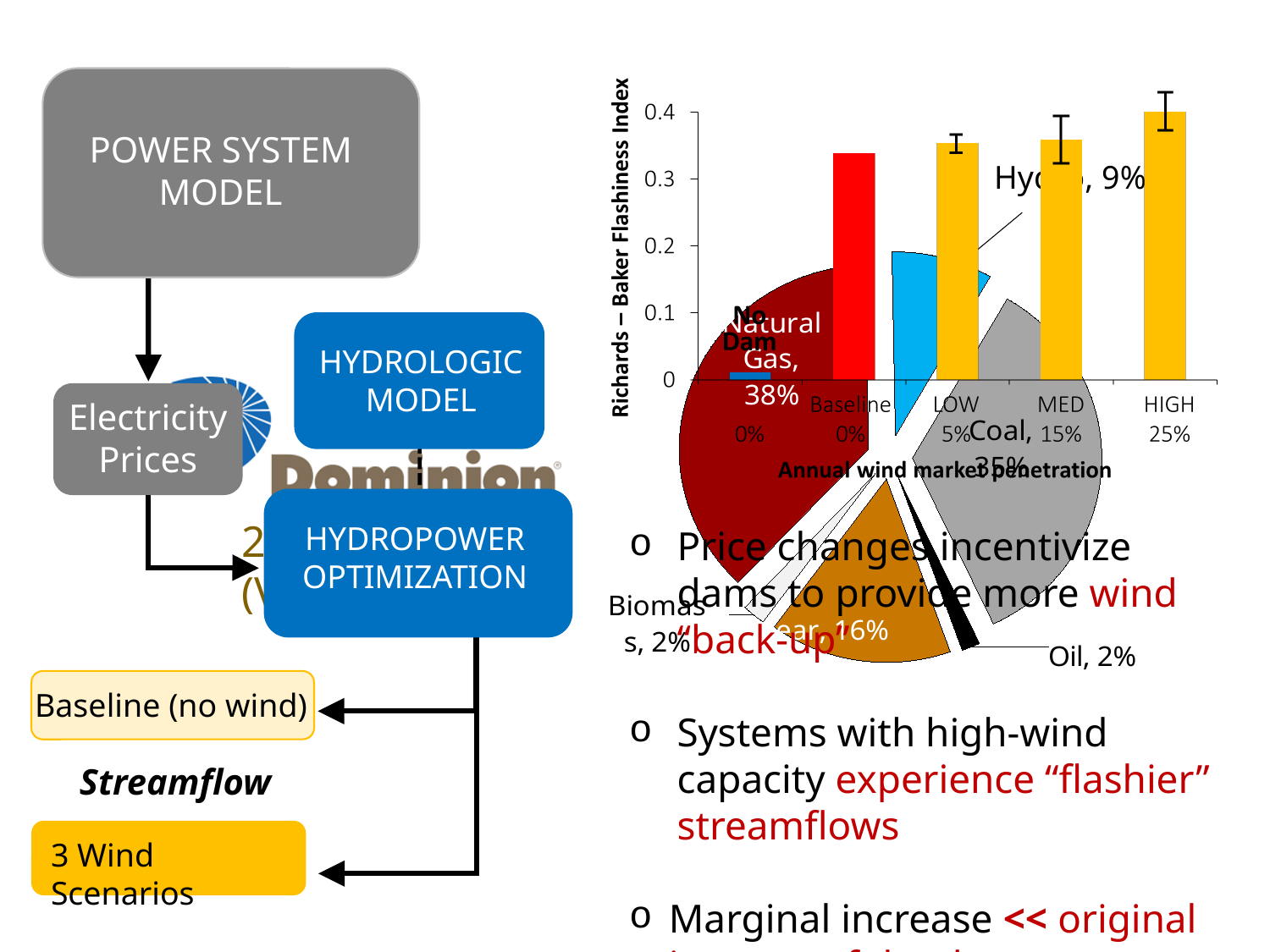
In the pie chart, what share does Coal have? 35% In the Richards – Baker Flashiness Index bar chart, do the values rise or fall from LOW to HIGH? rise How many categories are shown on the x axis of the Richards – Baker Flashiness Index bar chart? 5 In the pie chart, what share does Natural Gas have? 38% In the Richards – Baker Flashiness Index bar chart, is the value for No Dam greater or less than 0.1? less In the Richards – Baker Flashiness Index bar chart, is the value for MED greater or less than 0.3? greater In the Richards – Baker Flashiness Index bar chart, is the value for Baseline greater or less than 0.3? greater What is the x axis title of the Richards – Baker Flashiness Index bar chart? Annual wind market penetration In the Richards – Baker Flashiness Index bar chart, which category has the lowest value? No Dam In the Richards – Baker Flashiness Index bar chart, which category has the highest value? HIGH What kind of chart is the chart with the y axis labelled Richards – Baker Flashiness Index? bar chart In the Richards – Baker Flashiness Index bar chart, which is larger, the value for HIGH or the value for Baseline? HIGH